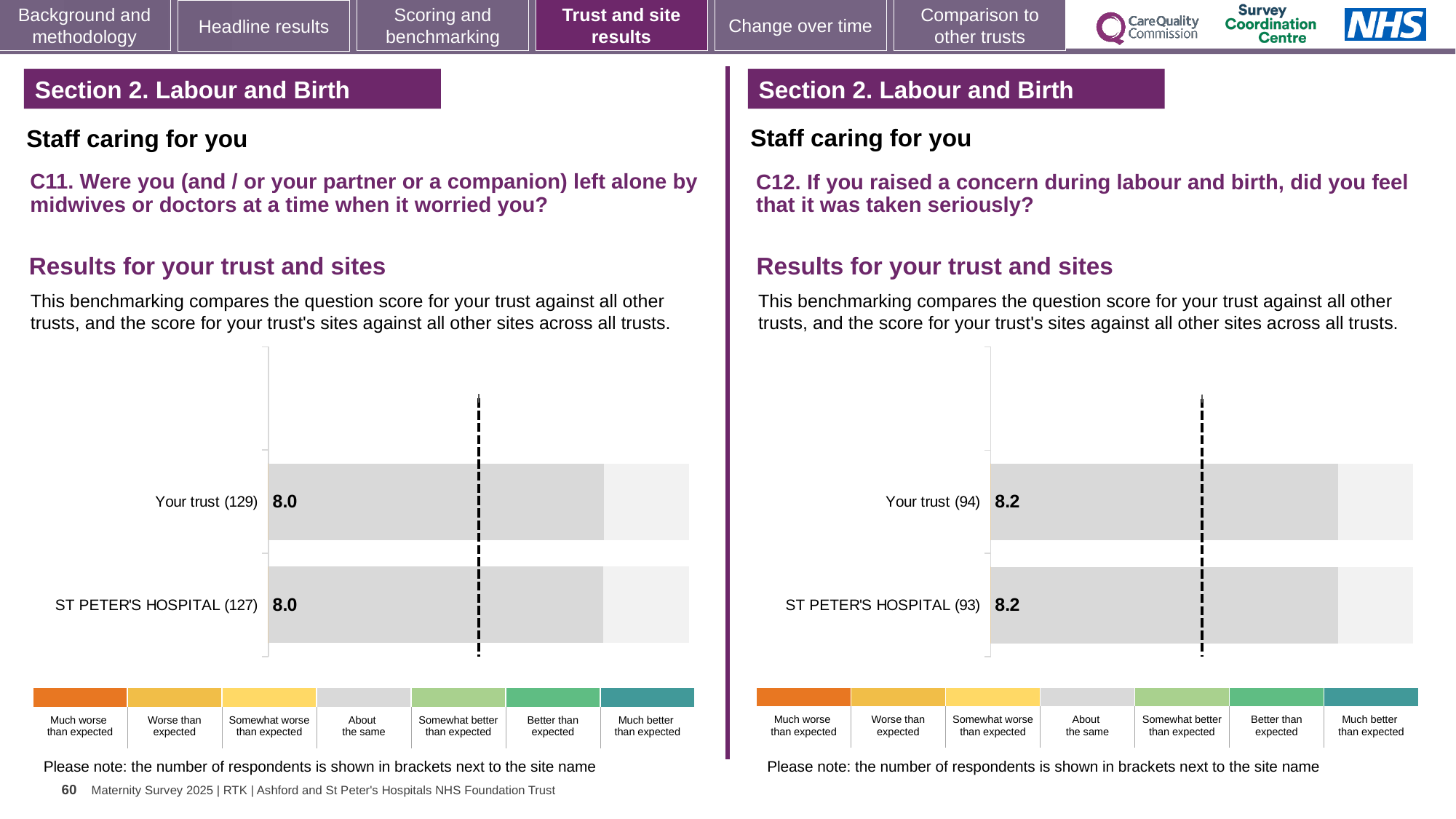
In the C12 chart on the right, what is the score for Your trust? 8.2 In the C12 chart on the right, how many respondents are shown in brackets for ST PETER'S HOSPITAL? 93 How many categories does the colour key below the C12 chart on the right list? 7 In the C11 chart on the left, what is the score for Your trust? 8.0 In the C11 chart on the left, how many respondents are shown in brackets for Your trust? 129 How many bars are plotted in the C11 chart on the left? 2 In the C11 chart on the left, what is the difference between the Your trust score and the ST PETER'S HOSPITAL score? 0.0 In the C12 chart on the right, what is the score for ST PETER'S HOSPITAL? 8.2 In the C11 chart on the left, what is the score for ST PETER'S HOSPITAL? 8.0 What kind of chart is used for the C11 results on the left? Bar chart What is the difference between the Your trust score in the C12 chart on the right and the Your trust score in the C11 chart on the left? 0.2 How many bars are plotted in the C12 chart on the right? 2